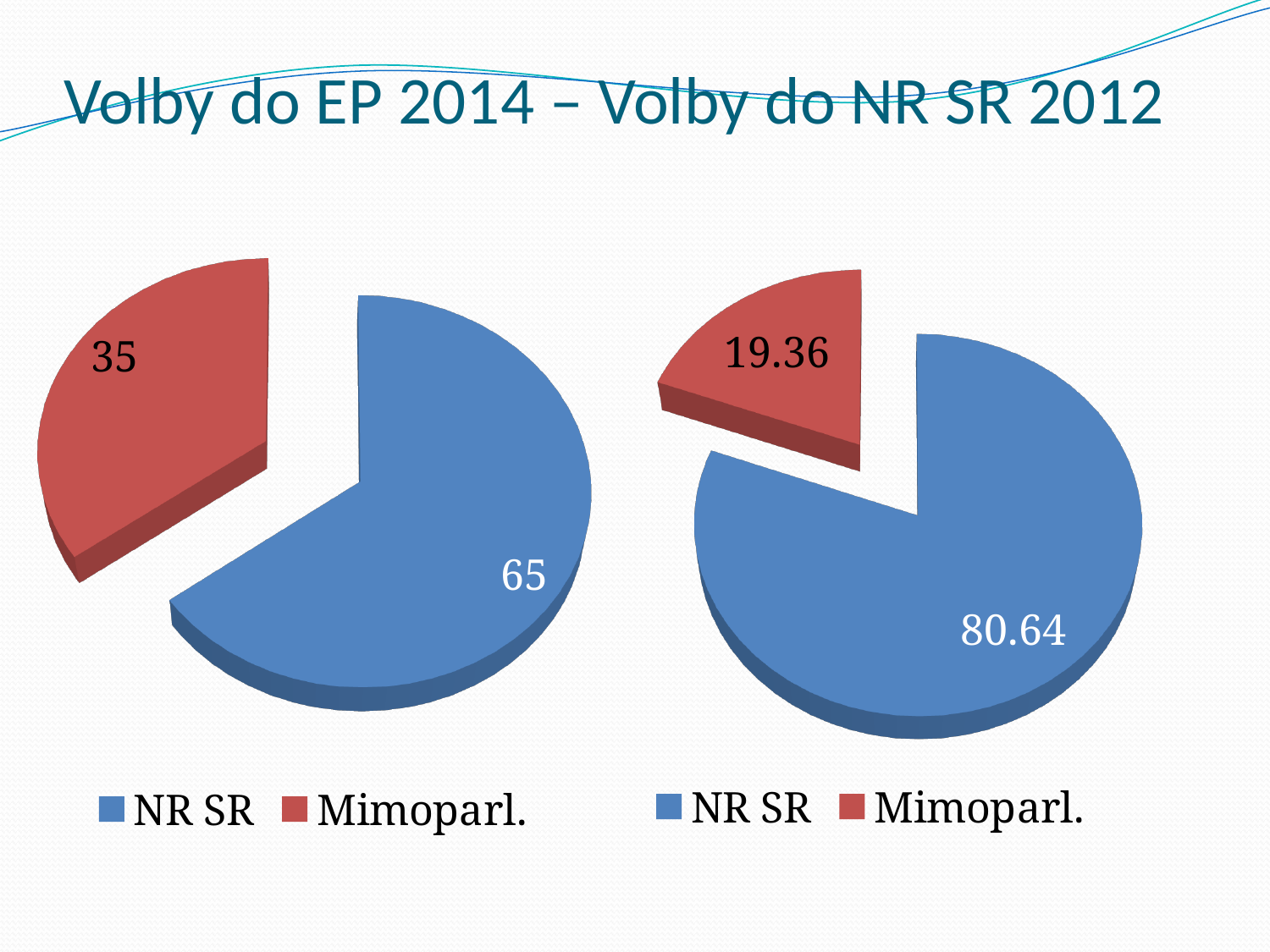
Is the Mimoparl. value larger in the left pie chart or in the right pie chart? left pie chart In the left pie chart, which category has the largest slice? NR SR In the right pie chart, what is the value for Mimoparl.? 19.36 In the right pie chart, what is the difference between the NR SR value and the Mimoparl. value? 61.28 In the right pie chart, what is the value for NR SR? 80.64 What kind of chart is the left chart on the slide? pie chart How many slices does the right pie chart have? 2 What colour is the Mimoparl. slice in the left pie chart? red In the left pie chart, what is the value for NR SR? 65 In the left pie chart, what is the value for Mimoparl.? 35 In the right pie chart, which category has the smallest slice? Mimoparl. In the left pie chart, what is the difference between the NR SR value and the Mimoparl. value? 30